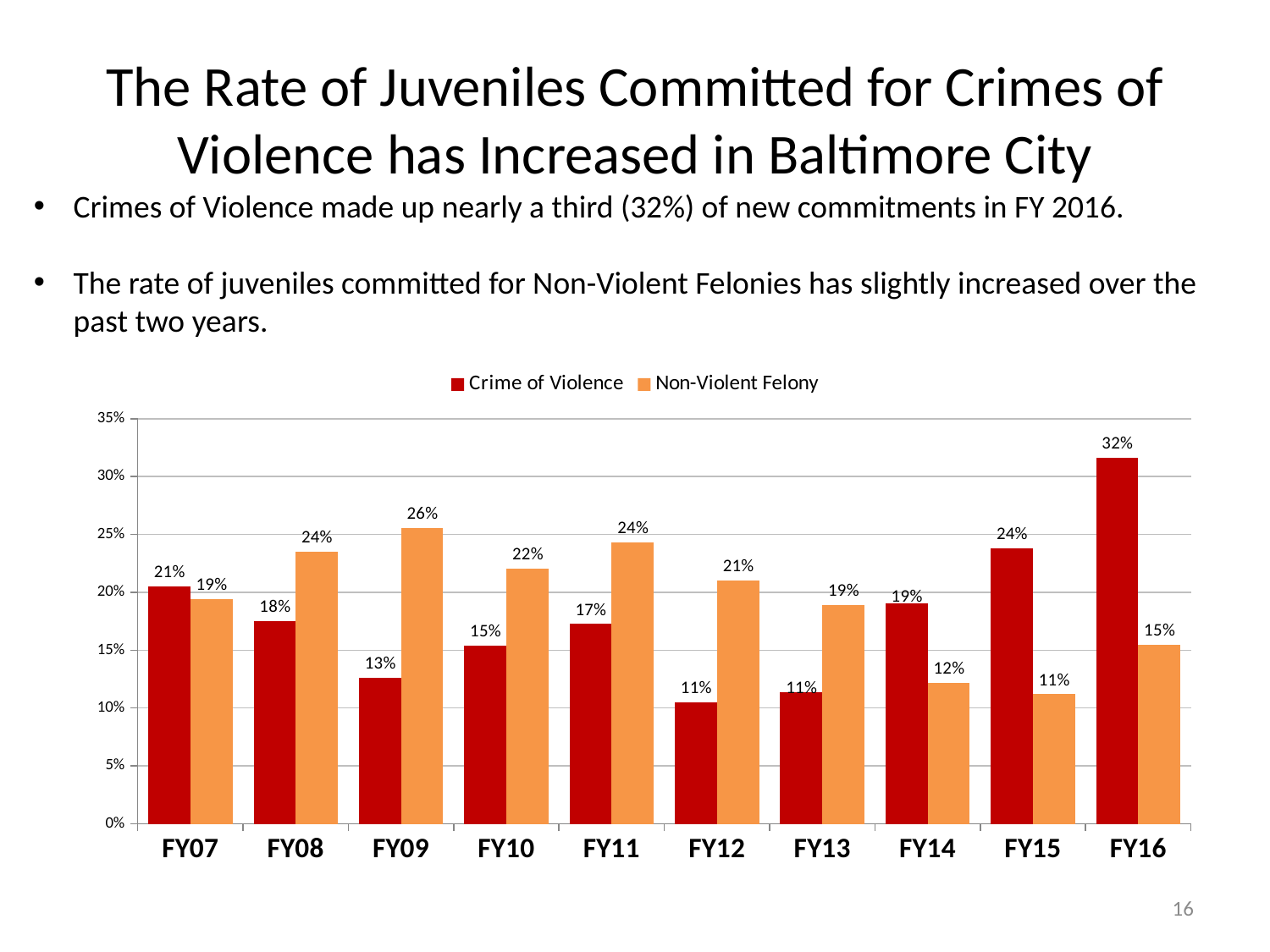
What kind of chart is shown on the slide? Bar chart In FY14, which series has the larger value, Crime of Violence or Non-Violent Felony? Crime of Violence Is the Non-Violent Felony value for FY11 greater or less than 20%? greater How many series does the legend list? 2 How many fiscal years are shown on the x axis? 10 What is the Crime of Violence value for FY10? 15% What is the Non-Violent Felony value for FY09? 26% From FY13 to FY16, does the Crime of Violence value rise or fall? Rise Which fiscal year has the highest Non-Violent Felony value? FY09 Which fiscal year has the highest Crime of Violence value? FY16 What is the difference between the Crime of Violence and Non-Violent Felony values in FY16? 17 percentage points What is the Crime of Violence value for FY16? 32%